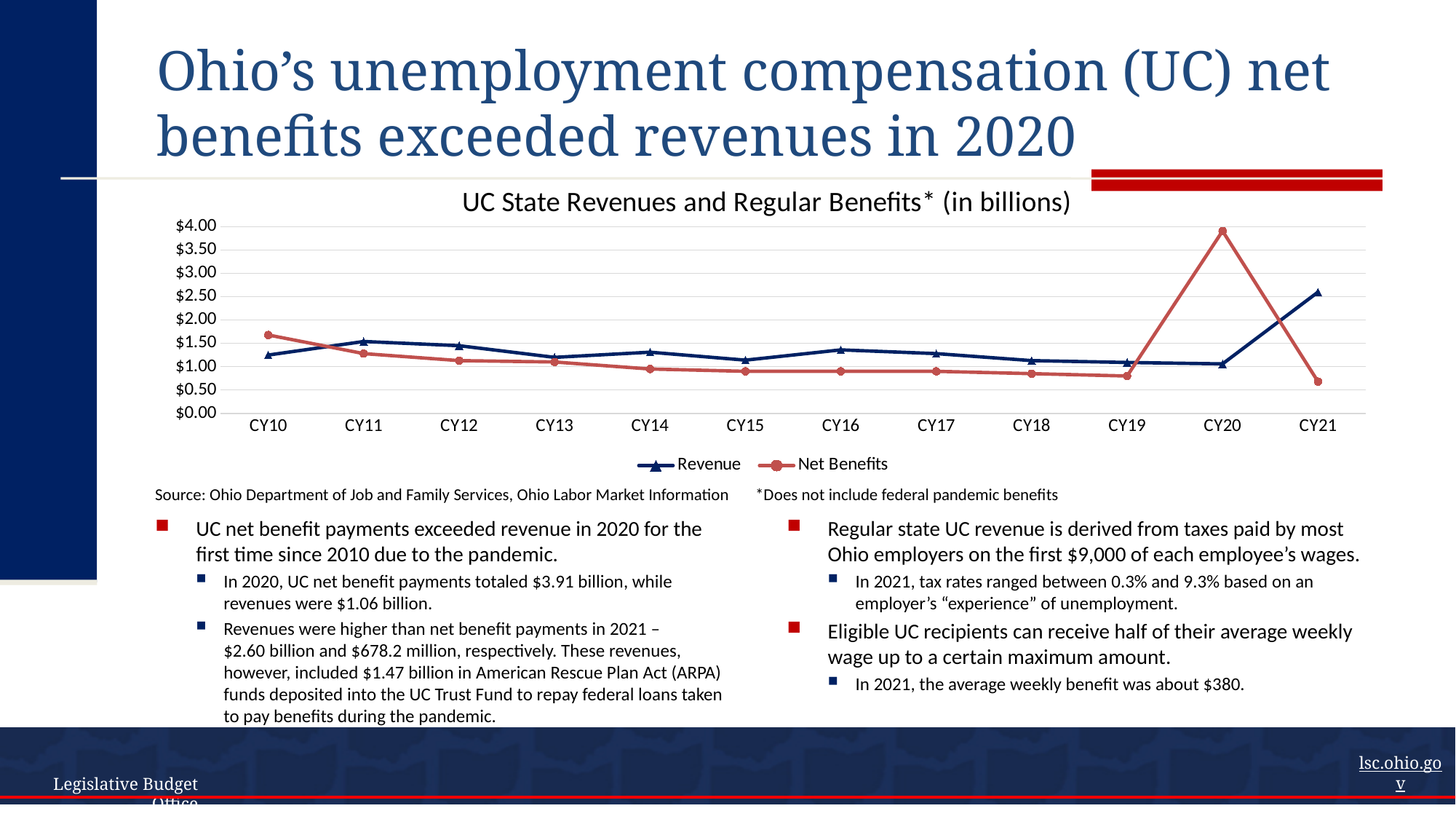
How many calendar years are plotted along the x axis of the chart? 12 Is the Net Benefits value for CY21 greater or less than $1.00? less In which year is the Net Benefits series at its lowest value? CY21 What kind of chart is shown on the slide? line chart In which year does the Net Benefits series reach its highest value? CY20 In CY21, which series has the larger value, Revenue or Net Benefits? Revenue Does the Net Benefits series generally rise or fall from CY10 to CY19? fall How many series does the chart's legend list? 2 Is the Net Benefits value for CY20 greater or less than $3.50? greater Is the Revenue value for CY21 greater or less than $2.00? greater In CY20, which series has the larger value, Revenue or Net Benefits? Net Benefits In which year does the Revenue series reach its highest value? CY21